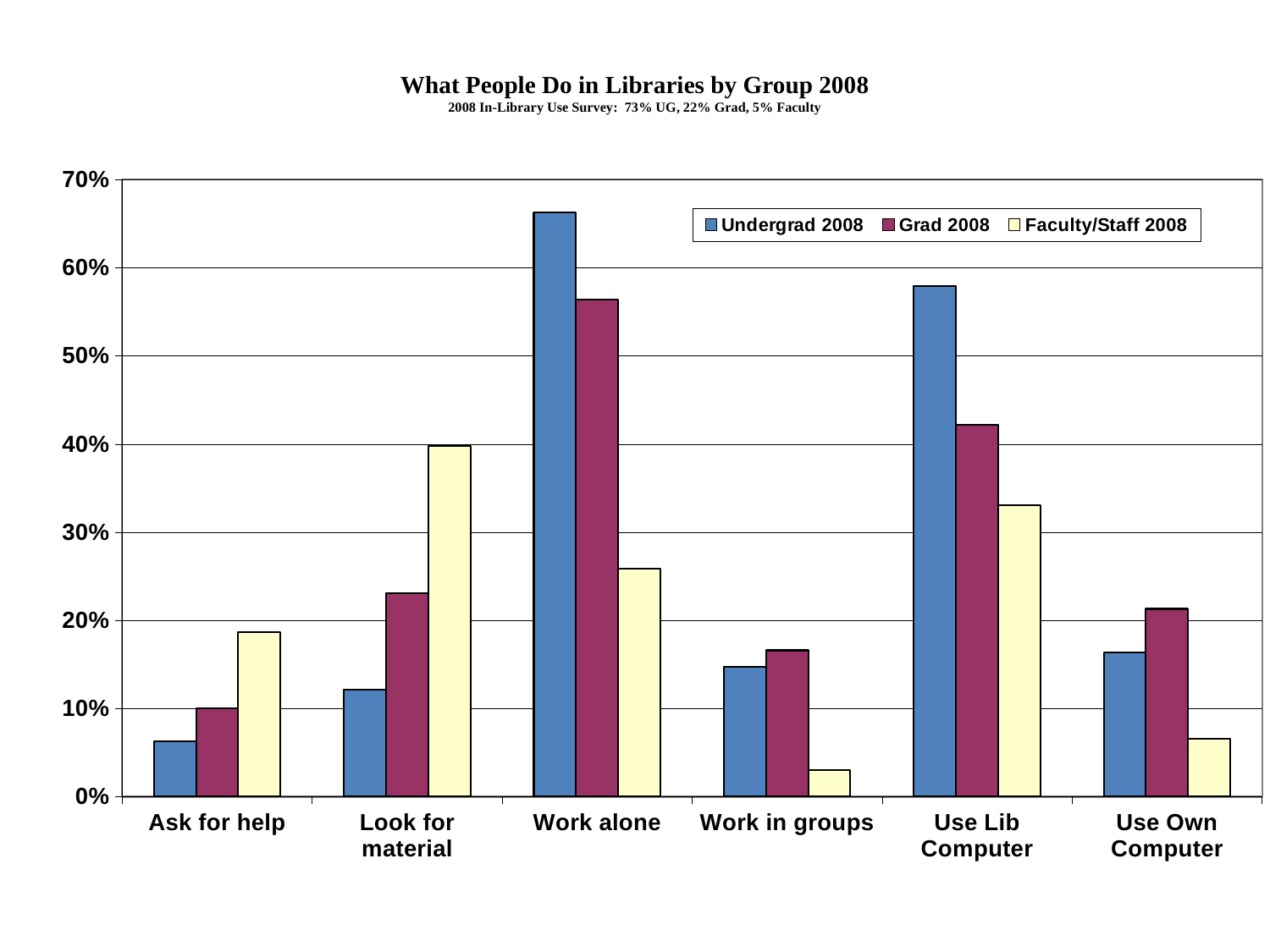
For Look for material, which group has the larger value: Undergrad 2008 or Faculty/Staff 2008? Faculty/Staff 2008 Which activity has the highest value for Undergrad 2008? Work alone Is the value for Faculty/Staff 2008 in Use Own Computer greater or less than 10%? less What kind of chart is shown on the slide? bar chart Which activity has the highest value for Faculty/Staff 2008? Look for material How many series does the legend list? 3 How many activity categories are shown on the x axis? 6 Is the value for Undergrad 2008 in Work alone greater or less than 60%? greater For Use Lib Computer, which group has the larger value: Undergrad 2008 or Grad 2008? Undergrad 2008 Is the value for Grad 2008 in Use Lib Computer greater or less than 40%? greater What is the title of the chart? What People Do in Libraries by Group 2008 Which activity has the lowest value for Faculty/Staff 2008? Work in groups